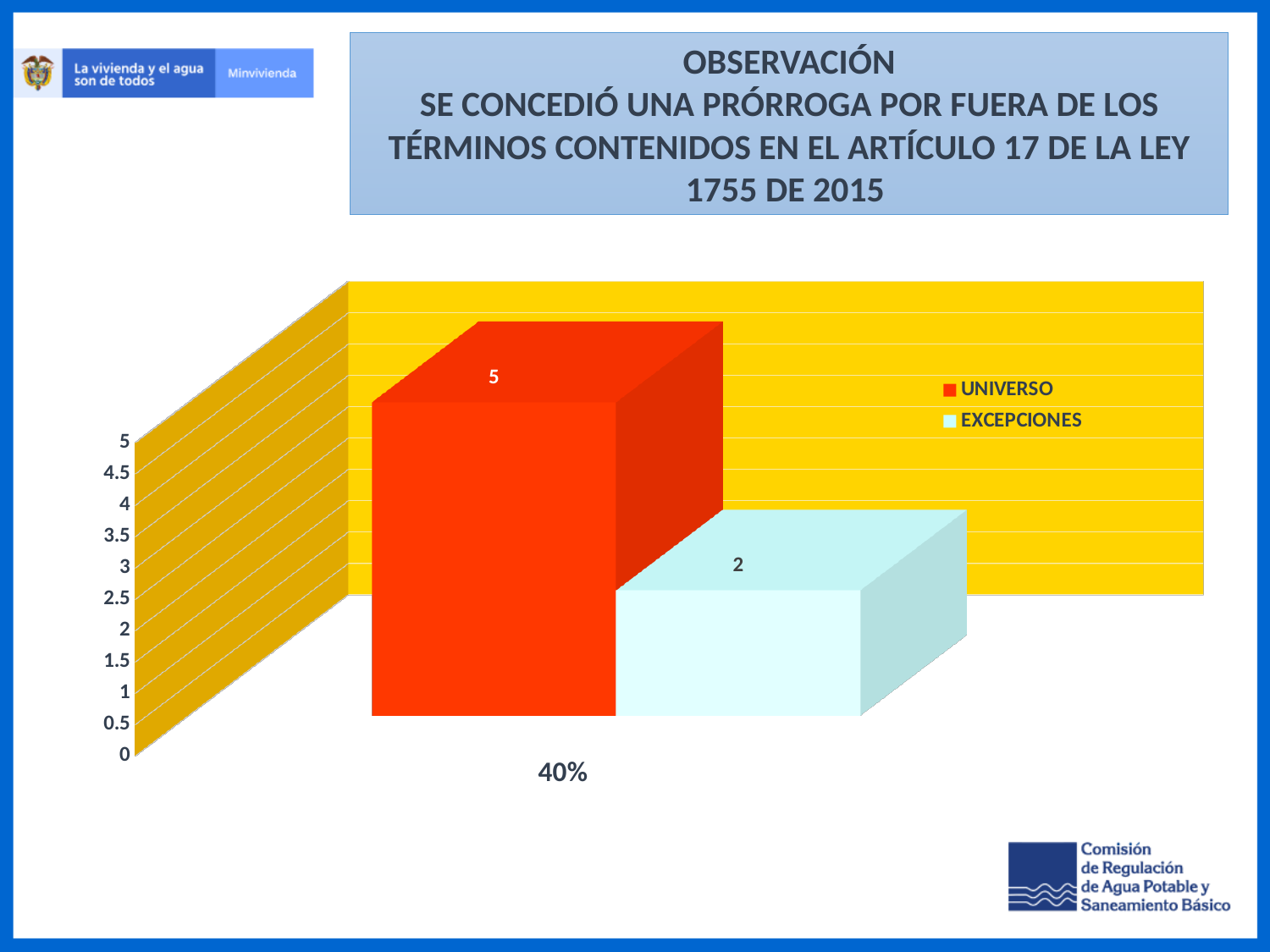
What is the category label shown below the bars? 40% What is the value of the EXCEPCIONES bar? 2 What is the difference between the UNIVERSO and EXCEPCIONES values? 3 What is the maximum value shown on the vertical axis? 5 Which series has the higher value, UNIVERSO or EXCEPCIONES? UNIVERSO What colour is the UNIVERSO bar? red What kind of chart is shown on the slide? bar chart Which series has the lowest value? EXCEPCIONES How many series does the legend list? 2 Is the value for EXCEPCIONES greater or less than 3? less What is the value of the UNIVERSO bar? 5